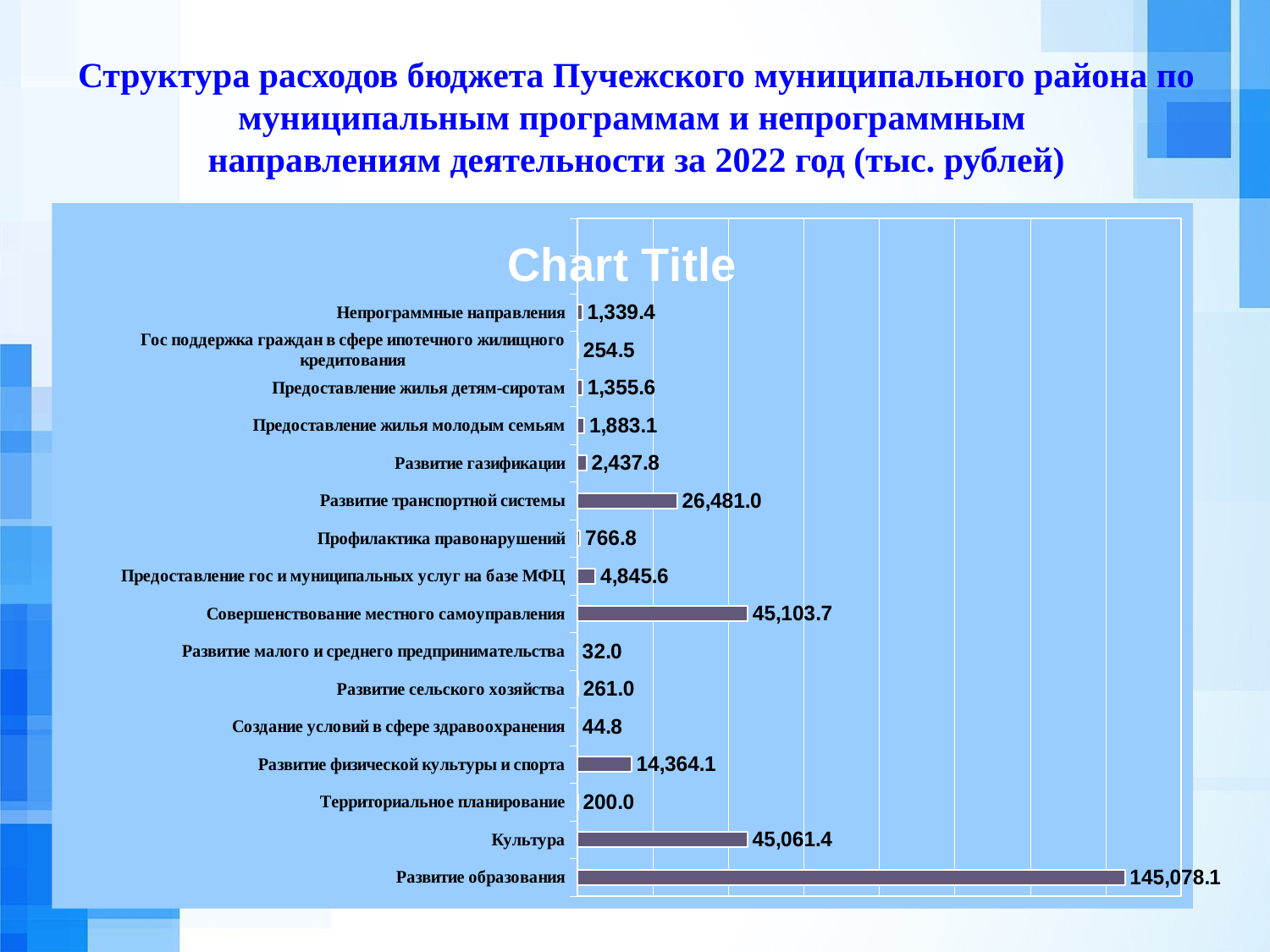
What is the value for Предоставление гос и муниципальных услуг на базе МФЦ? 4,845.6 What is the value for Территориальное планирование? 200.0 What title is printed inside the chart area? Chart Title What type of chart is shown on the slide? Bar chart How many categories are plotted in the chart? 16 Which is larger: the value for Развитие газификации or the value for Предоставление жилья молодым семьям? Развитие газификации What is the value for Развитие образования? 145,078.1 What is the value for Развитие транспортной системы? 26,481.0 Which category has the highest value? Развитие образования What is the difference between the values for Развитие транспортной системы and Развитие физической культуры и спорта? 12,116.9 What is the difference between the values for Развитие образования and Совершенствование местного самоуправления? 99,974.4 Which category has the lowest value? Развитие малого и среднего предпринимательства